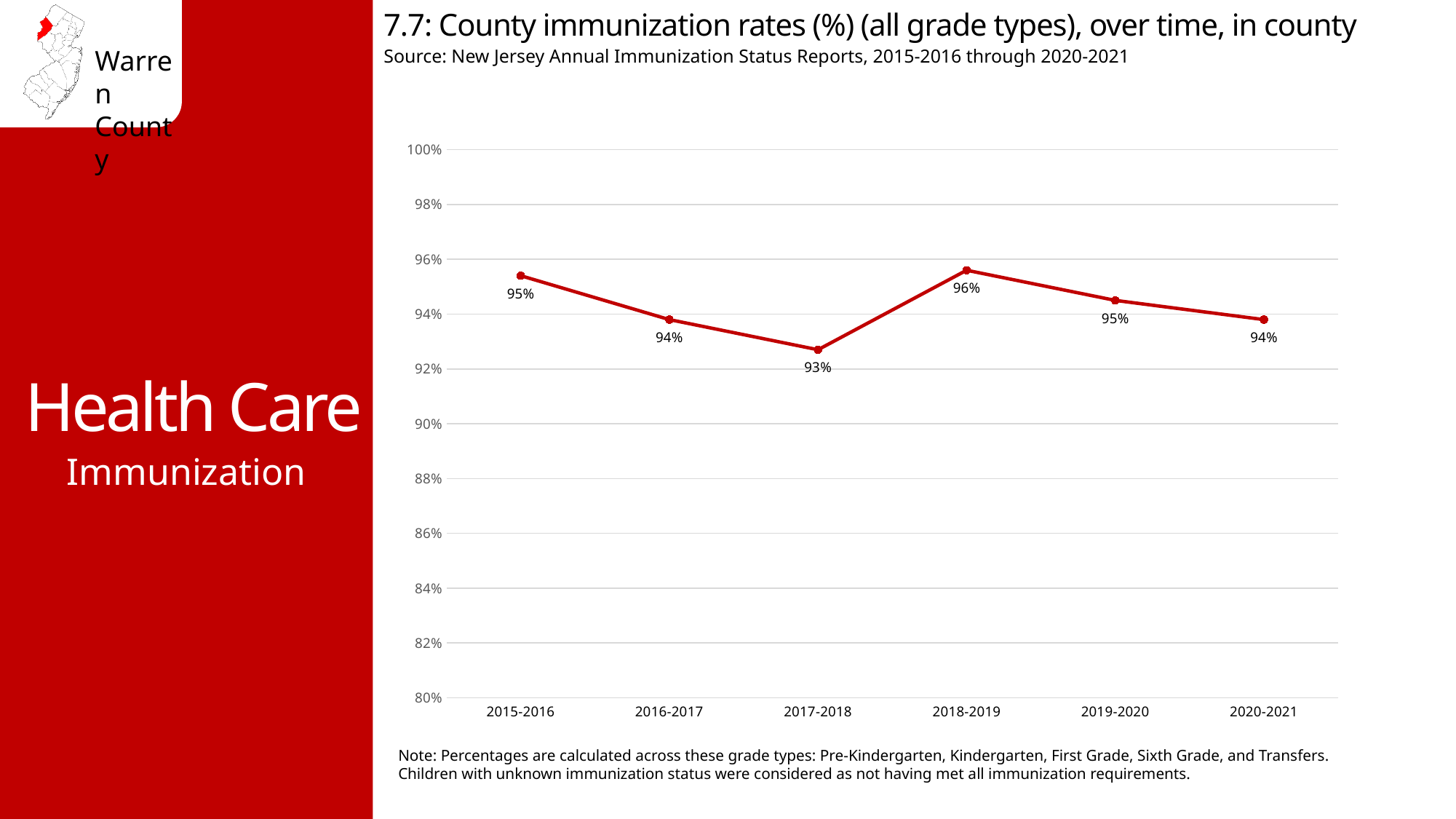
Do the immunization rates rise or fall from 2018-2019 to 2020-2021? Fall Which school year has the lowest immunization rate? 2017-2018 What kind of chart is shown on the slide? Line chart Which year has a higher immunization rate, 2015-2016 or 2016-2017? 2015-2016 What is the county immunization rate for 2017-2018? 93% What is the difference between the immunization rate in 2018-2019 and in 2017-2018? 3 percentage points Is the value for 2018-2019 greater or less than 94%? greater How many school years are plotted on the chart? 6 What is the county immunization rate for 2020-2021? 94% Is the value for 2017-2018 greater or less than 94%? less What is the county immunization rate for 2018-2019? 96% Which school year has the highest immunization rate? 2018-2019